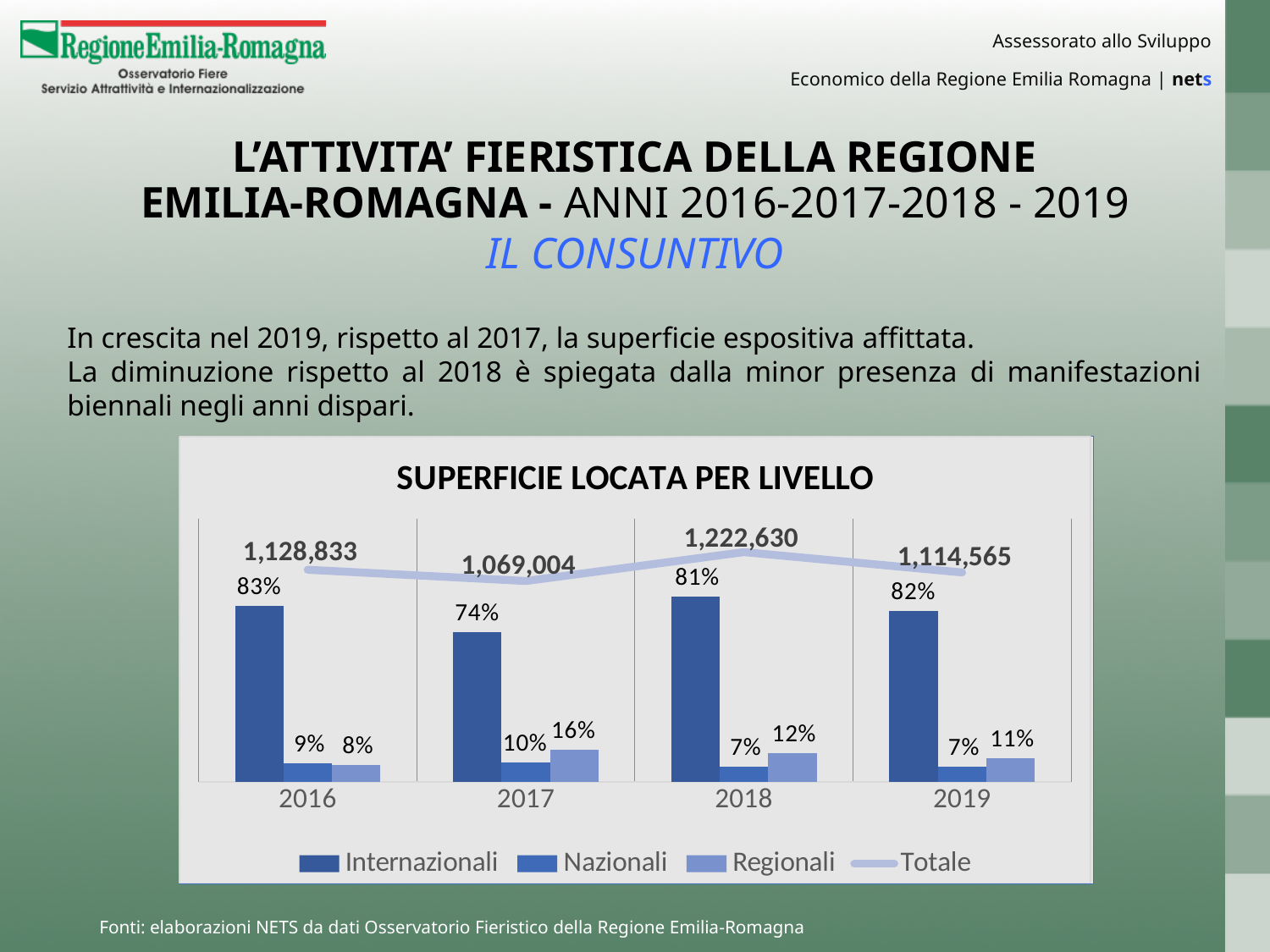
What is the title of the chart? SUPERFICIE LOCATA PER LIVELLO What is the difference between the Totale values for 2018 and 2017? 153,626 What is the Regionali share in 2016? 8% In which year is the Totale value highest? 2018 What kind of chart is used for the Internazionali, Nazionali and Regionali series? Bar chart What is the Totale value for 2018? 1,222,630 How many years are shown on the x axis? 4 Which is larger, the Regionali share in 2017 or in 2019? 2017 How many series does the legend list? 4 What is the Internazionali share in 2017? 74% In which year is the Internazionali share lowest? 2017 What is the Nazionali share in 2019? 7%